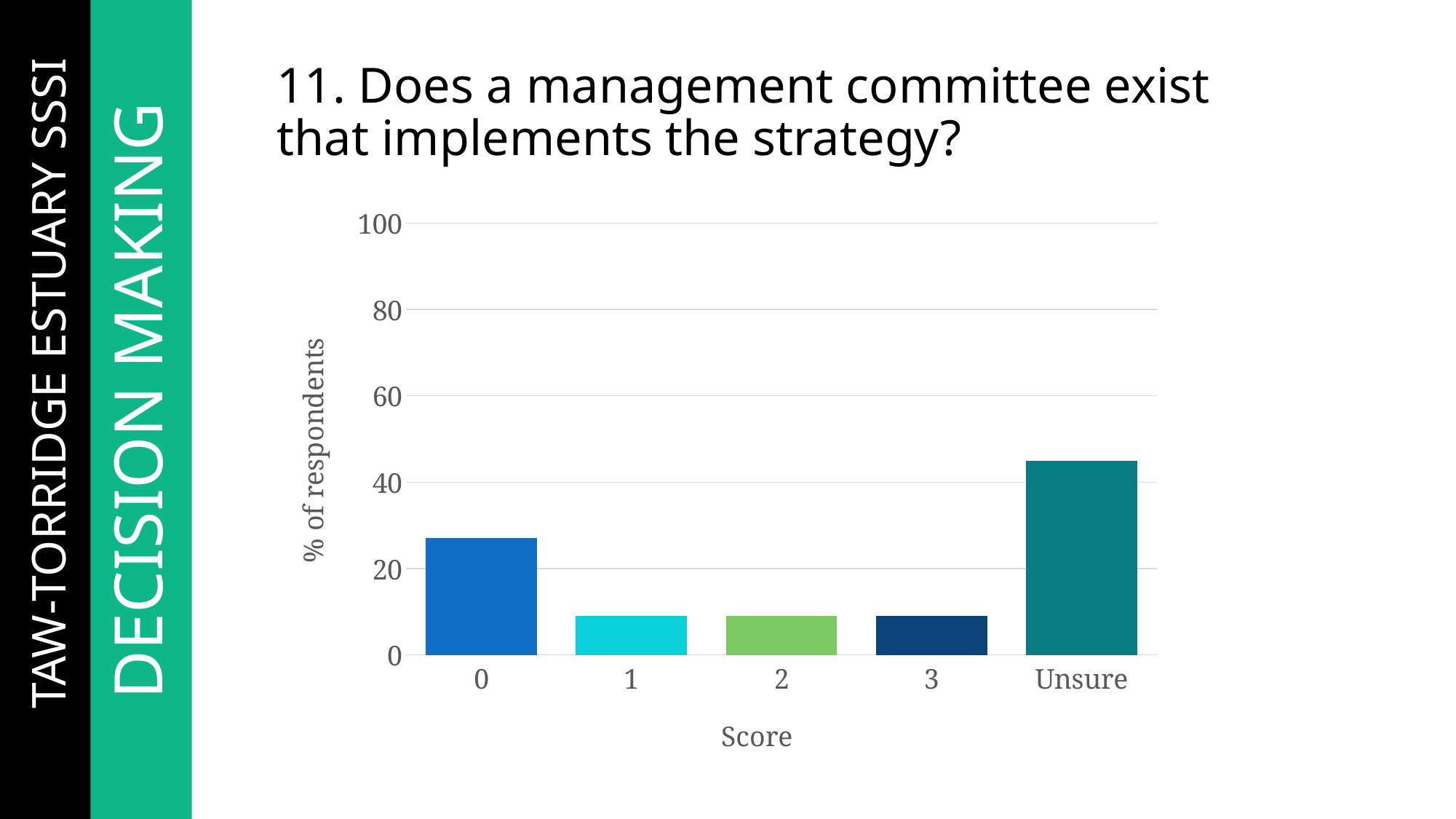
Is the value for Unsure greater or less than 60? less What is the label on the horizontal axis of the chart? Score Which has a higher percentage of respondents, score 0 or score 2? score 0 Is the value for score 3 greater or less than 20? less What is the label on the vertical axis of the chart? % of respondents How many score categories are shown on the x axis of the chart? 5 Which has a higher percentage of respondents, Unsure or score 0? Unsure Which score category has the highest percentage of respondents? Unsure Is the value for score 1 greater or less than 20? less What kind of chart is shown on the slide? bar chart